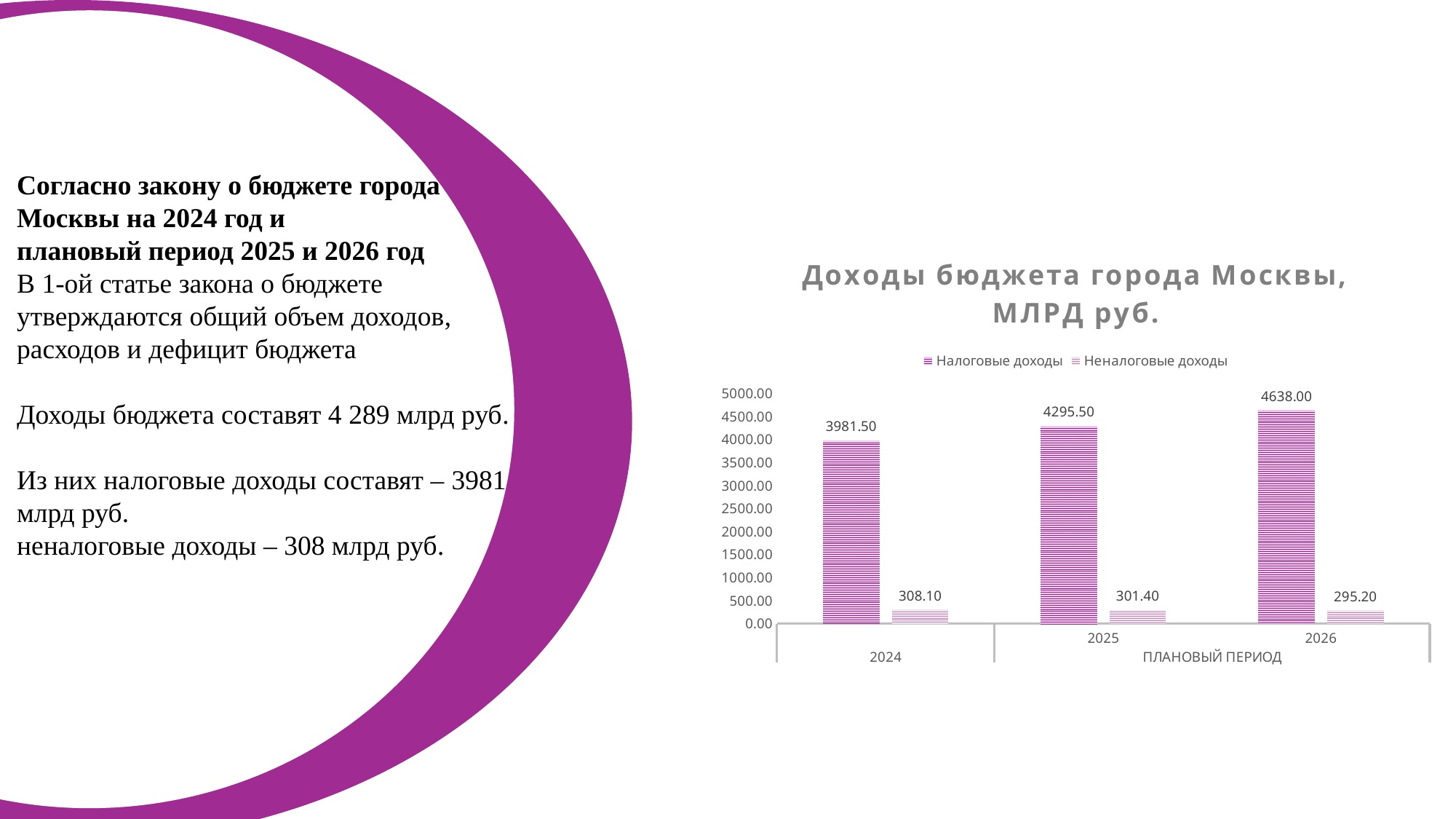
Which year has the highest value for Налоговые доходы? 2026 What kind of chart is shown on the slide? bar chart How many years are shown on the x axis? 3 Which is larger: Неналоговые доходы in 2024 or in 2025? 2024 What is the value of Налоговые доходы for 2025? 4295.50 What is the value of Налоговые доходы for 2024? 3981.50 How many series does the legend list? 2 What is the difference between Налоговые доходы in 2026 and in 2024? 656.50 What is the value of Неналоговые доходы for 2026? 295.20 Is the value for Налоговые доходы in 2026 greater or less than 4500.00? greater Do the values for Налоговые доходы rise or fall from 2024 to 2026? rise Which year has the lowest value for Неналоговые доходы? 2026